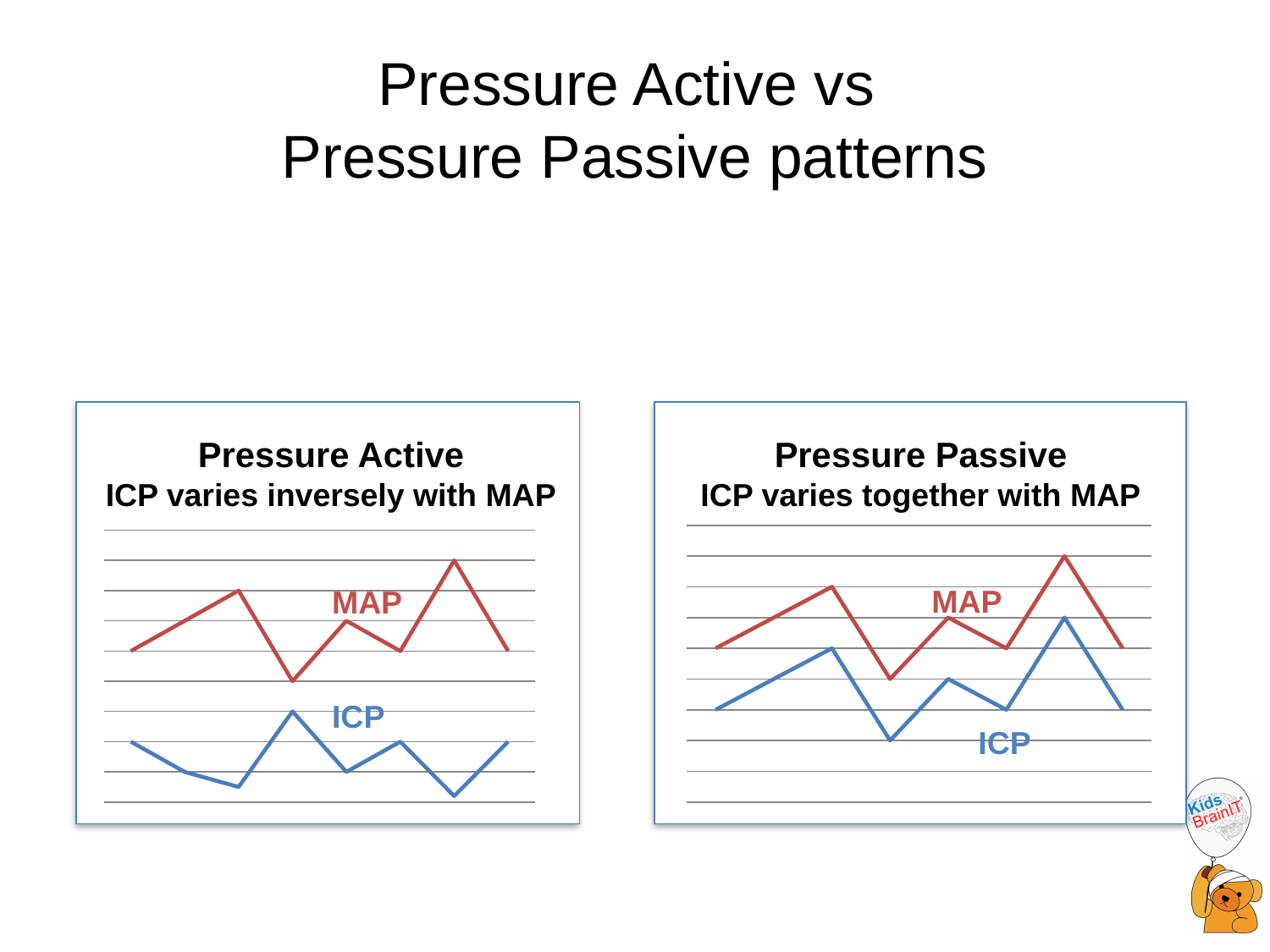
What kind of chart is the Pressure Passive chart on the right? line chart In the Pressure Active chart, which series has the lowest point, MAP or ICP? ICP What kind of chart is the Pressure Active chart on the left? line chart How many series are plotted in the Pressure Passive chart? 2 What colour is the ICP line in the Pressure Passive chart? blue How many series are plotted in the Pressure Active chart? 2 What is the subtitle of the Pressure Active chart? ICP varies inversely with MAP In the Pressure Passive chart, which series reaches the highest point, MAP or ICP? MAP In the Pressure Active chart, which series is plotted higher on the chart, MAP or ICP? MAP